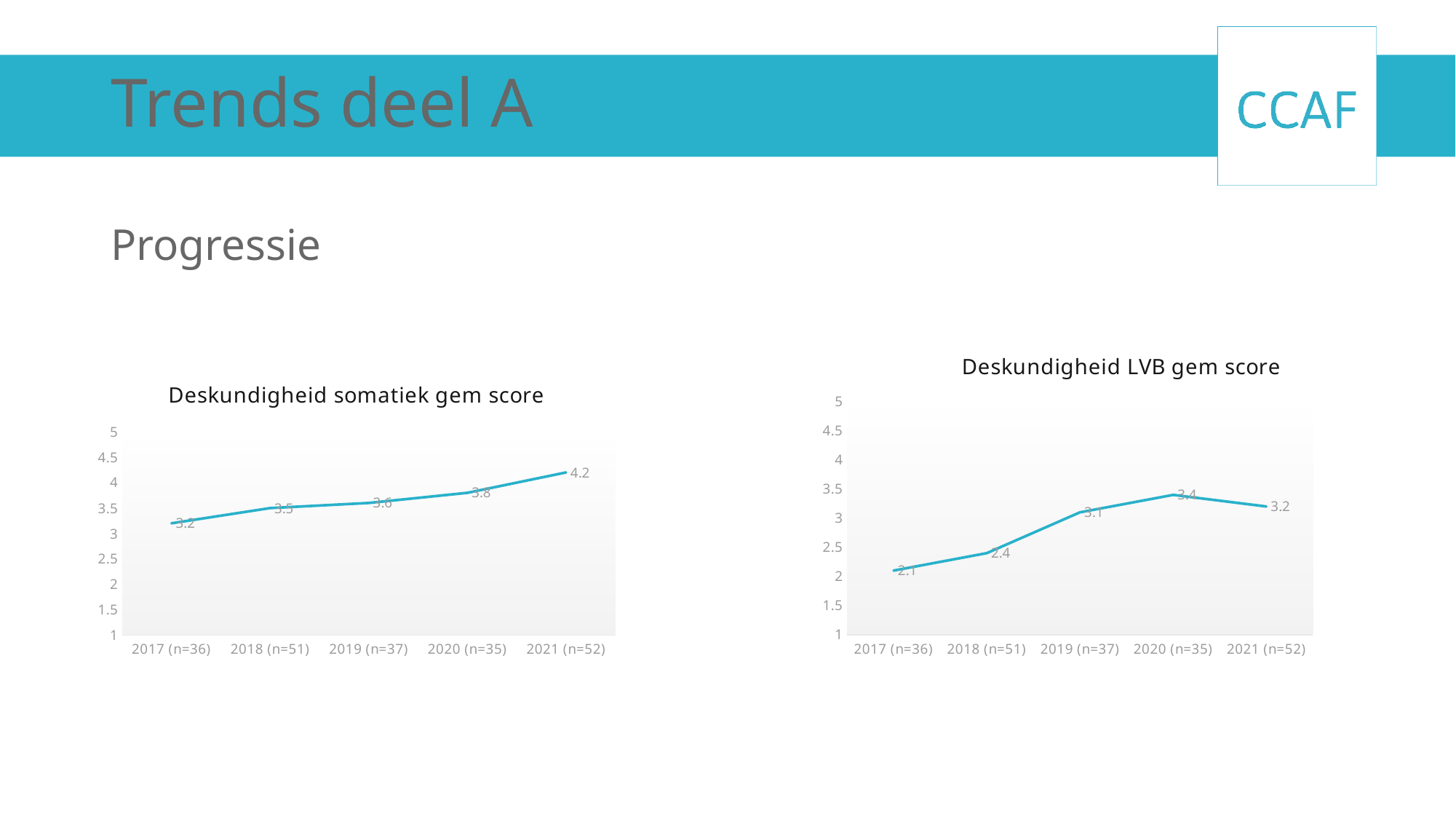
How many data points are plotted in the 'Deskundigheid somatiek gem score' chart? 5 In the 'Deskundigheid somatiek gem score' chart, what is the difference between the 2021 (n=52) and 2017 (n=36) values? 1.0 In the 'Deskundigheid LVB gem score' chart, what is the value for 2019 (n=37)? 3.1 What kind of chart is the 'Deskundigheid LVB gem score' chart? line chart In the 'Deskundigheid LVB gem score' chart, what is the value for 2017 (n=36)? 2.1 In the 'Deskundigheid somatiek gem score' chart, is the value for 2021 (n=52) greater or less than 4? greater In the 'Deskundigheid LVB gem score' chart, which is larger: the value for 2020 (n=35) or 2021 (n=52)? 2020 (n=35) In the 'Deskundigheid LVB gem score' chart, what is the difference between the 2020 (n=35) and 2018 (n=51) values? 1.0 In the 'Deskundigheid somatiek gem score' chart, what is the value for 2021 (n=52)? 4.2 In the 'Deskundigheid LVB gem score' chart, which year has the highest value? 2020 (n=35) In the 'Deskundigheid somatiek gem score' chart, do the values rise or fall from 2017 to 2021? rise In the 'Deskundigheid somatiek gem score' chart, which year has the lowest value? 2017 (n=36)